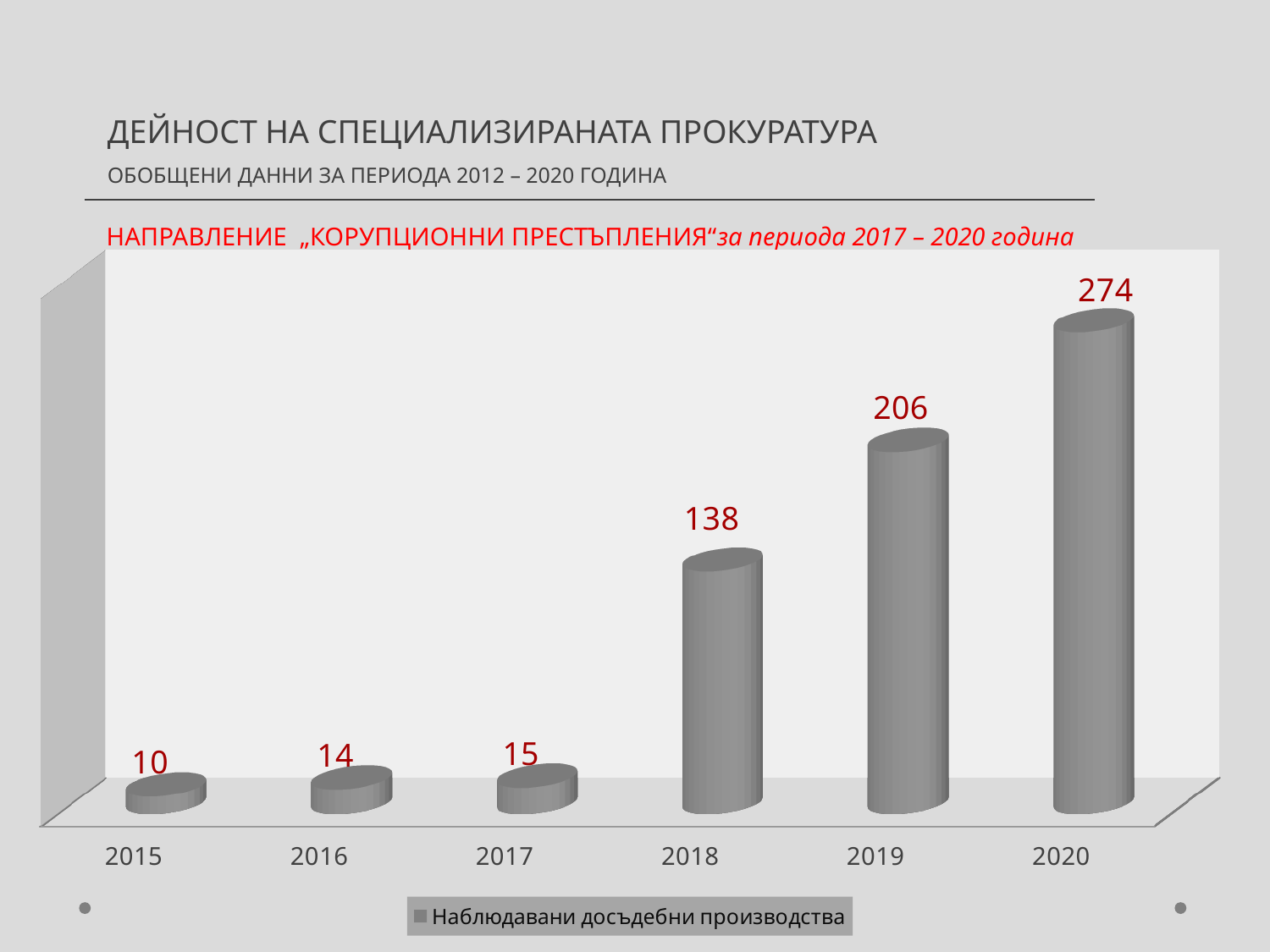
Which year has the lowest value? 2015 What kind of chart is shown? bar chart Which year has the highest value? 2020 How many series does the legend list? 1 What is the value for 2015? 10 Which is larger, the value for 2016 or the value for 2019? 2019 What is the value for 2018? 138 What is the value for 2020? 274 What is the difference between the values for 2020 and 2019? 68 What is the difference between the values for 2018 and 2017? 123 How many years are shown on the x axis? 6 Do the values rise or fall from 2015 to 2020? rise